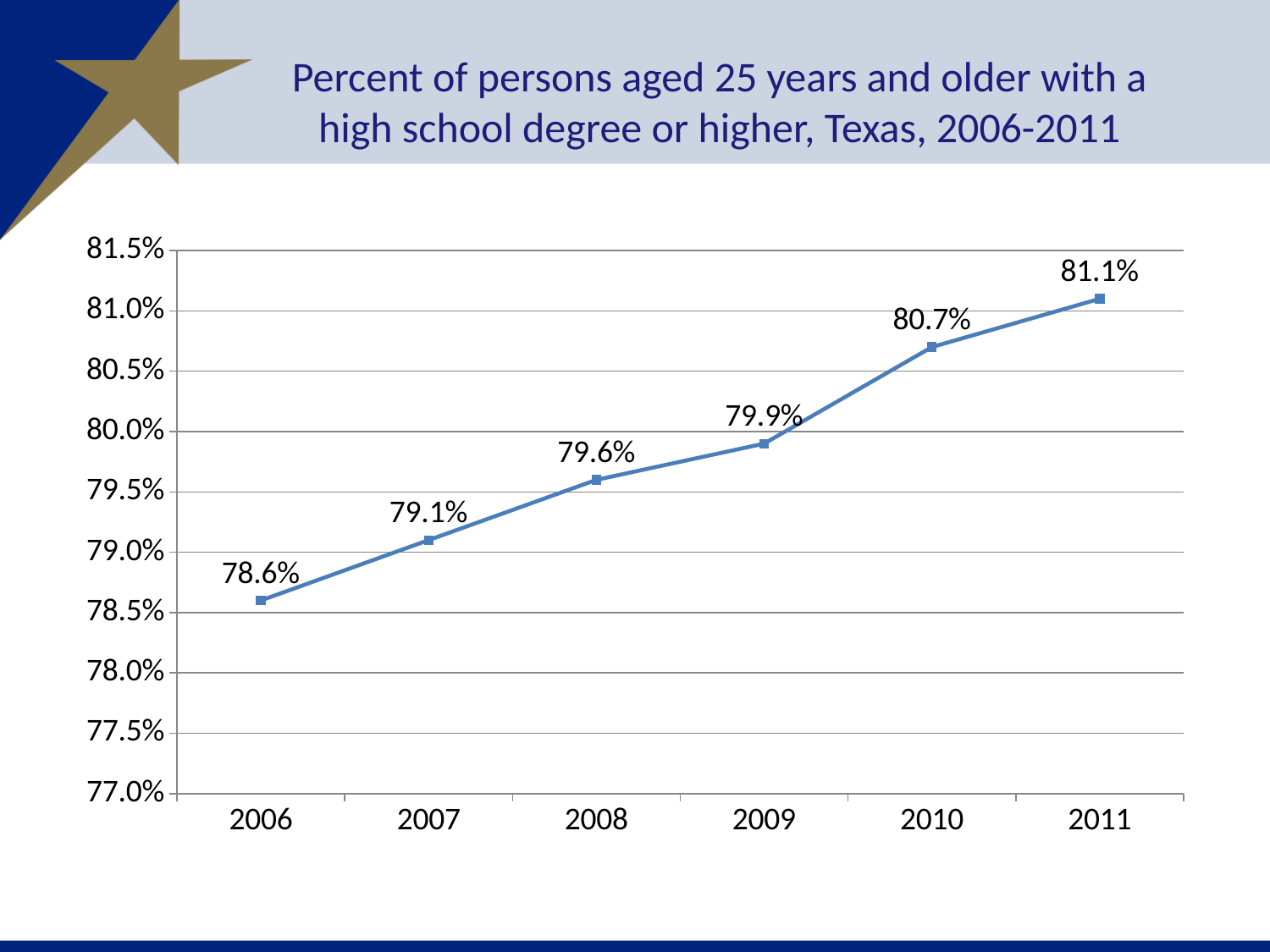
What kind of chart is shown on the slide? line chart Do the values rise or fall from 2006 to 2011? rise What is the value for 2006? 78.6% What is the value for 2009? 79.9% Which is larger, the value for 2008 or the value for 2010? 2010 What is the difference between the values for 2010 and 2009? 0.8% What is the value for 2011? 81.1% Which year has the highest value? 2011 Is the value for 2007 greater or less than 79.5%? less How many years are plotted on the chart? 6 What is the difference between the values for 2011 and 2006? 2.5% Which year has the lowest value? 2006